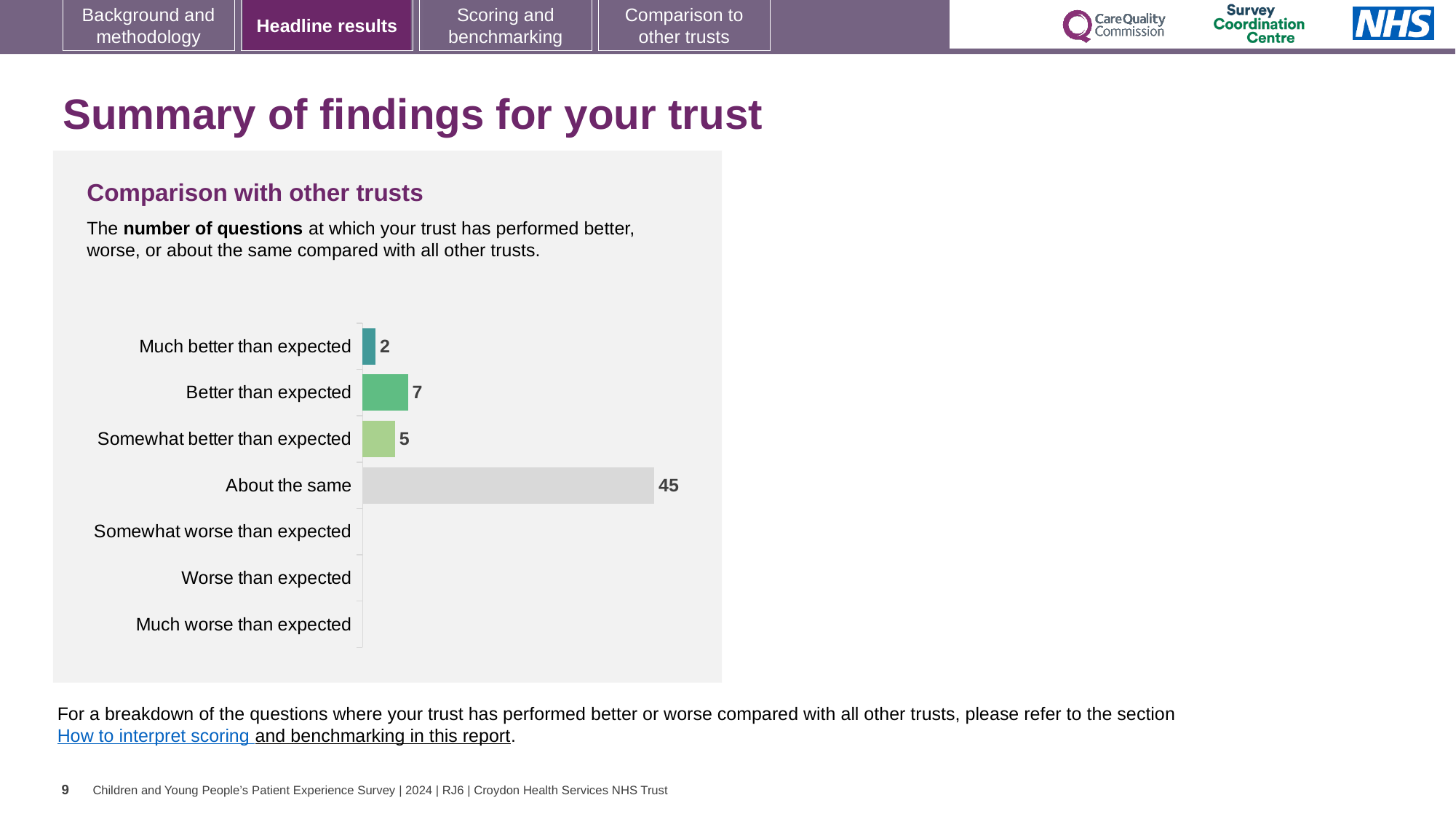
What is the value for 'Somewhat better than expected'? 5 What is the total number of questions across the three 'better than expected' categories? 14 What is the value for 'Better than expected'? 7 What is the title of the chart? Comparison with other trusts Which category has the highest number of questions? About the same What is the difference between 'Better than expected' and 'Somewhat better than expected'? 2 Which is larger, 'Better than expected' or 'Much better than expected'? Better than expected How many questions were rated 'About the same'? 45 How many categories are listed on the chart? 7 What is the difference between 'About the same' and 'Better than expected'? 38 What kind of chart is shown on the slide? Bar chart What is the value for 'Much better than expected'? 2